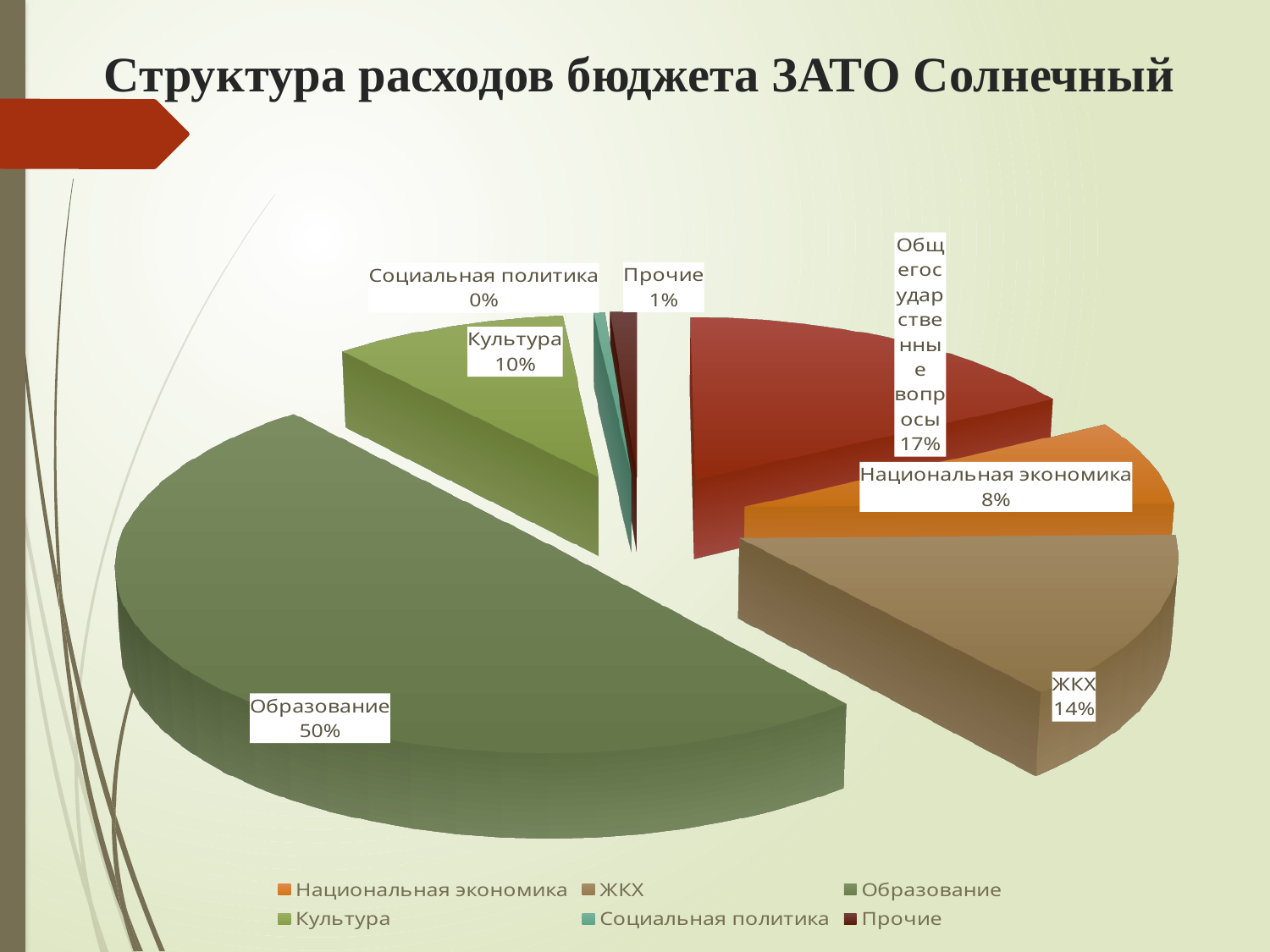
What share of the pie does Образование have? 50% What is the value shown for Национальная экономика? 8% Which category has the smallest share of the pie? Социальная политика How many categories are shown in the pie chart? 7 What is the difference between the shares of Общегосударственные вопросы and ЖКХ? 3% What type of chart is shown on the slide? Pie chart What is the value shown for Общегосударственные вопросы? 17% What is the value shown for Прочие? 1% Which is larger, the share of Культура or the share of Национальная экономика? Культура Which category has the largest share of the pie? Образование What is the value shown for Культура? 10% What is the value shown for ЖКХ? 14%